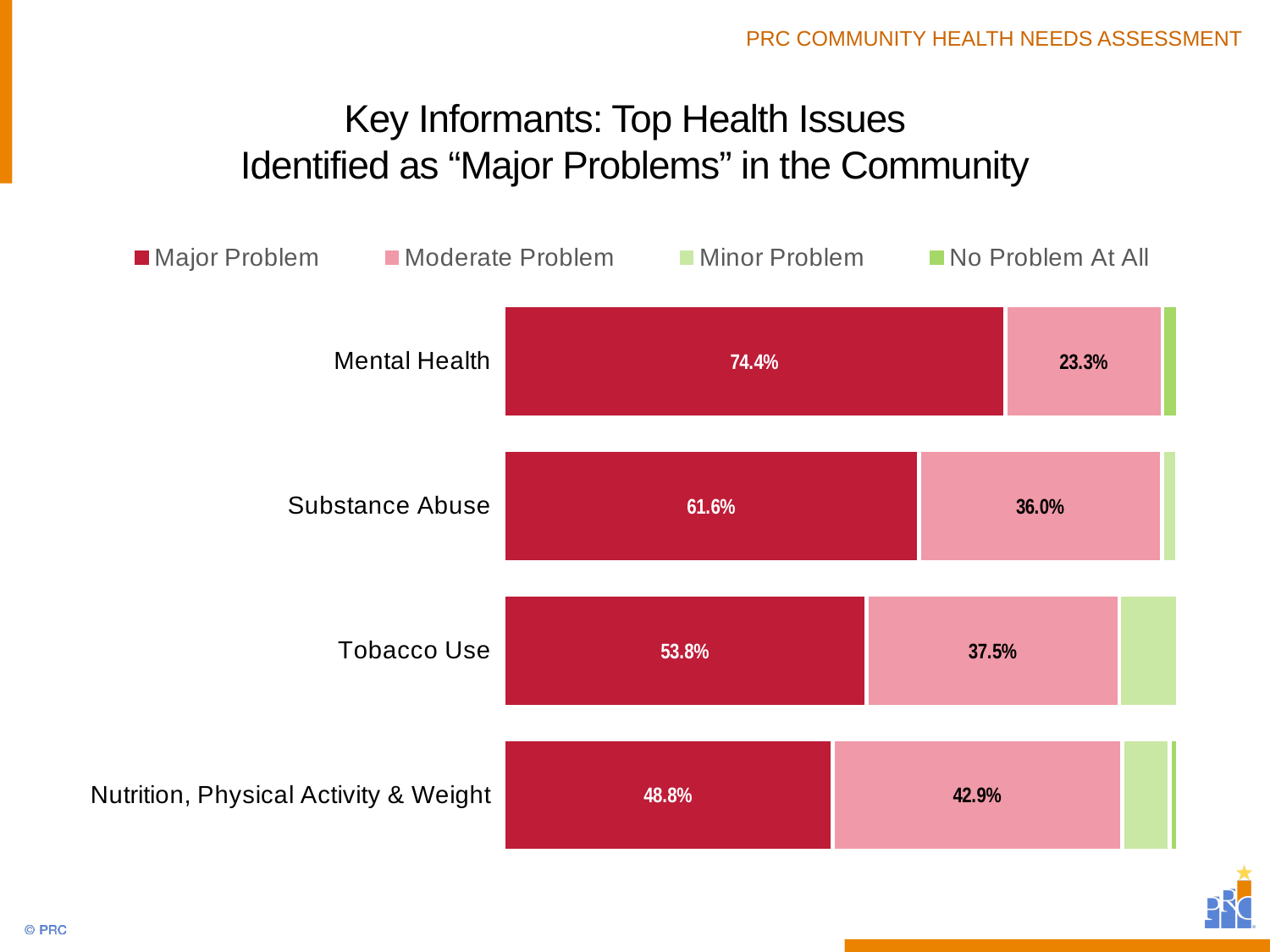
What is the Major Problem value for Nutrition, Physical Activity & Weight? 48.8% How many health issues are shown in the chart? 4 What is the Moderate Problem value for Tobacco Use? 37.5% What kind of chart is shown on the slide? Stacked bar chart What percentage of key informants rated Mental Health as a Major Problem? 74.4% Which health issue has the highest Moderate Problem percentage? Nutrition, Physical Activity & Weight What is the Moderate Problem value for Substance Abuse? 36.0% What is the difference between the Major Problem values for Mental Health and Substance Abuse? 12.8 percentage points Which is larger: the Major Problem value for Substance Abuse or for Tobacco Use? Substance Abuse Which health issue has the lowest Major Problem percentage? Nutrition, Physical Activity & Weight Which health issue has the highest Major Problem percentage? Mental Health How many series does the legend list? 4